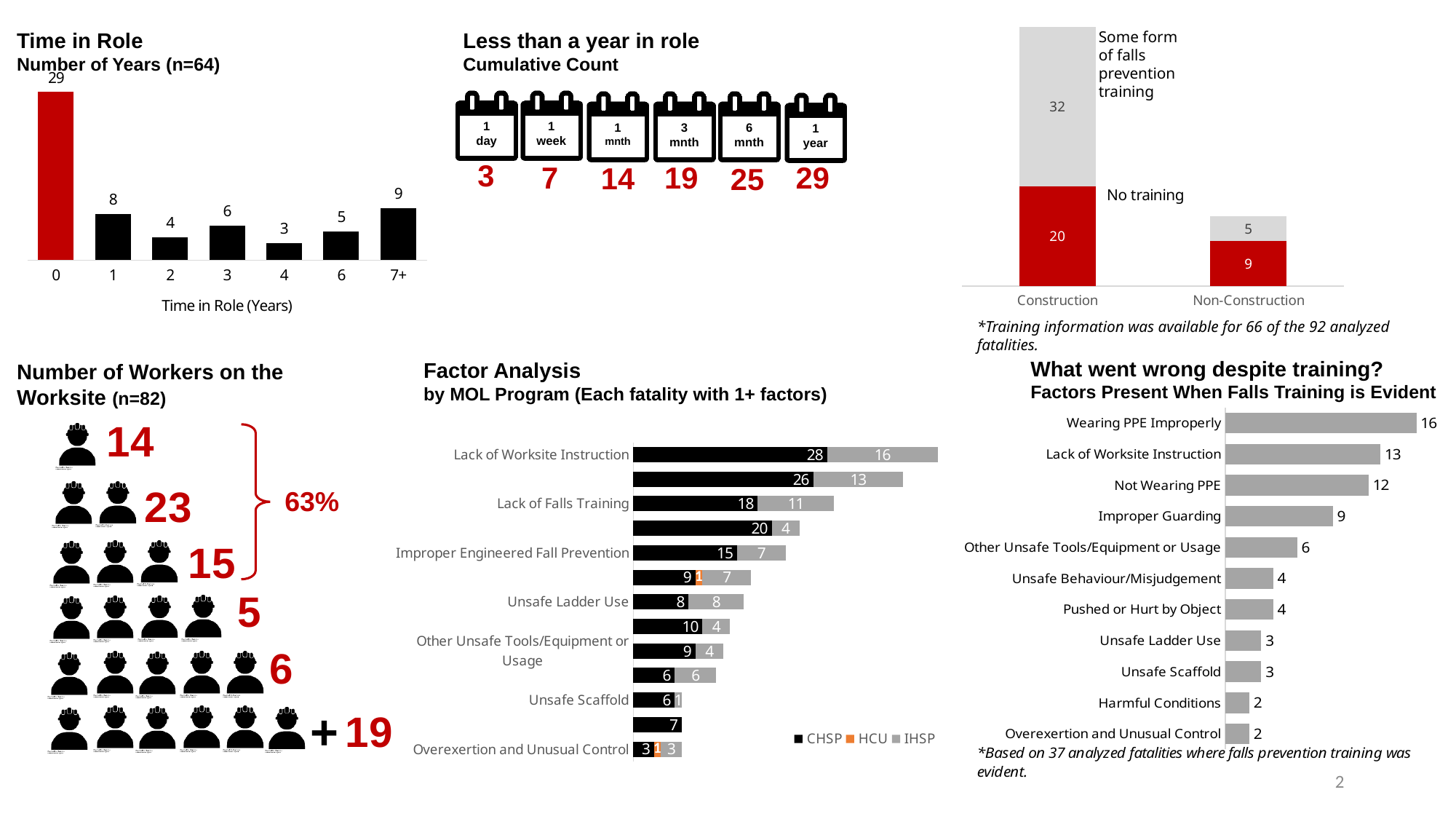
How many series does the legend of the 'Factor Analysis by MOL Program' chart list? 3 In the 'Time in Role' chart, what is the value for 0 years? 29 In the training chart at the top right, which is larger for Construction: 'Some form of falls prevention training' or 'No training'? Some form of falls prevention training In the training chart at the top right, what is the 'No training' value for Construction? 20 What kind of chart is the 'What went wrong despite training?' chart? Bar chart How many categories are shown on the x axis of the 'Time in Role' chart? 7 In the 'Factor Analysis by MOL Program' chart, what is the CHSP value for Lack of Worksite Instruction? 28 In the 'What went wrong despite training?' chart, which factor has the highest value? Wearing PPE Improperly In the 'What went wrong despite training?' chart, what is the value for Improper Guarding? 9 In the 'Time in Role' chart, which time-in-role category has the lowest value? 4 In the training chart at the top right, what is the total of the stacked bar for Non-Construction? 14 In the 'Time in Role' chart, what is the difference between the values for 7+ years and 1 year? 1